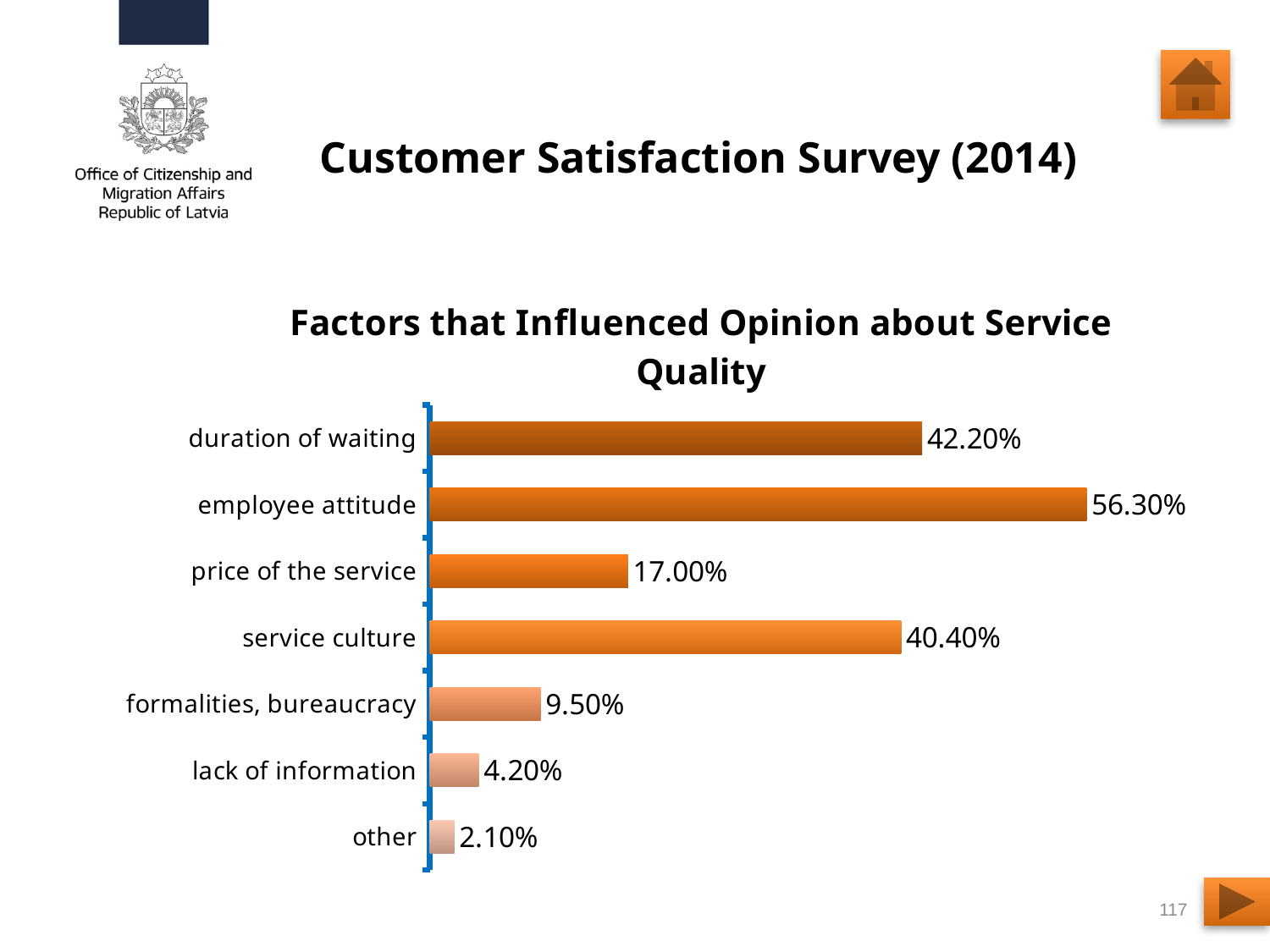
Which factor has the lowest value? other What is the value for formalities, bureaucracy? 9.50% What is the title of the chart? Factors that Influenced Opinion about Service Quality What is the value for employee attitude? 56.30% What is the difference between the values for price of the service and formalities, bureaucracy? 7.50% What is the value for duration of waiting? 42.20% Which factor has the highest value? employee attitude How many factors are shown in the chart? 7 What is the difference between the values for employee attitude and duration of waiting? 14.10% What is the value for lack of information? 4.20% Which is larger, the value for duration of waiting or the value for service culture? duration of waiting What kind of chart is shown on the slide? bar chart